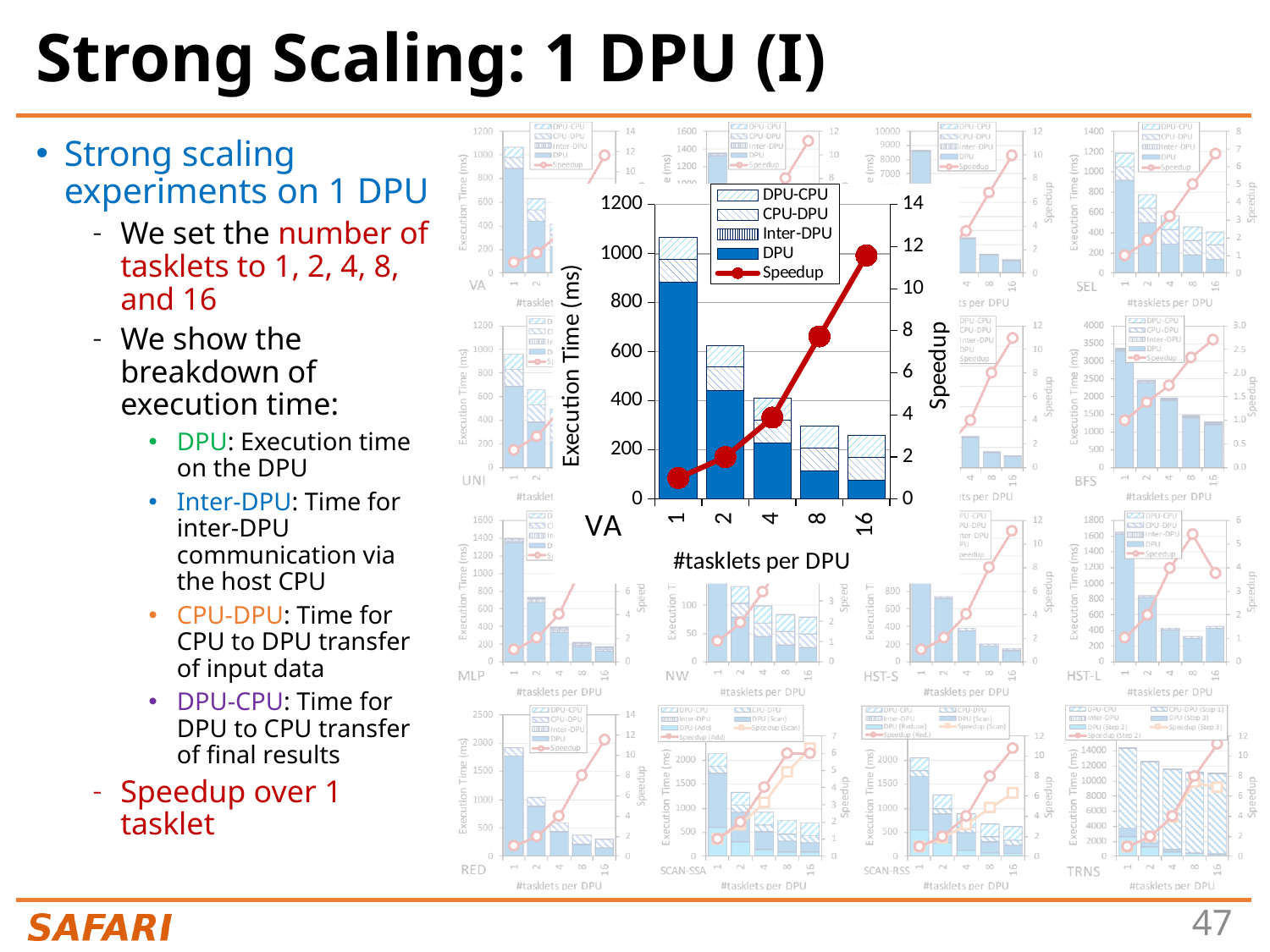
What is the x-axis label of the enlarged VA chart? #tasklets per DPU In the enlarged VA chart, is the Speedup for 16 tasklets greater or less than 10? greater In the enlarged VA chart, is the total execution time for 1 tasklet greater or less than 800 ms? greater In the enlarged VA chart, how many #tasklets per DPU values are shown on the x axis? 5 In the enlarged VA chart, which number of tasklets per DPU has the highest total execution time? 1 In the enlarged VA chart, is the total execution time for 16 tasklets greater or less than 400 ms? less In the enlarged VA chart, does the total execution time rise or fall as the number of tasklets per DPU increases? Fall In the enlarged VA chart, which has the larger total execution time: 1 tasklet or 16 tasklets? 1 tasklet What kind of chart is the enlarged VA chart in the centre of the slide? A stacked bar chart with a line for speedup In the enlarged VA chart, does the Speedup line rise or fall as the number of tasklets per DPU increases? Rise How many entries does the legend of the enlarged VA chart list? 5